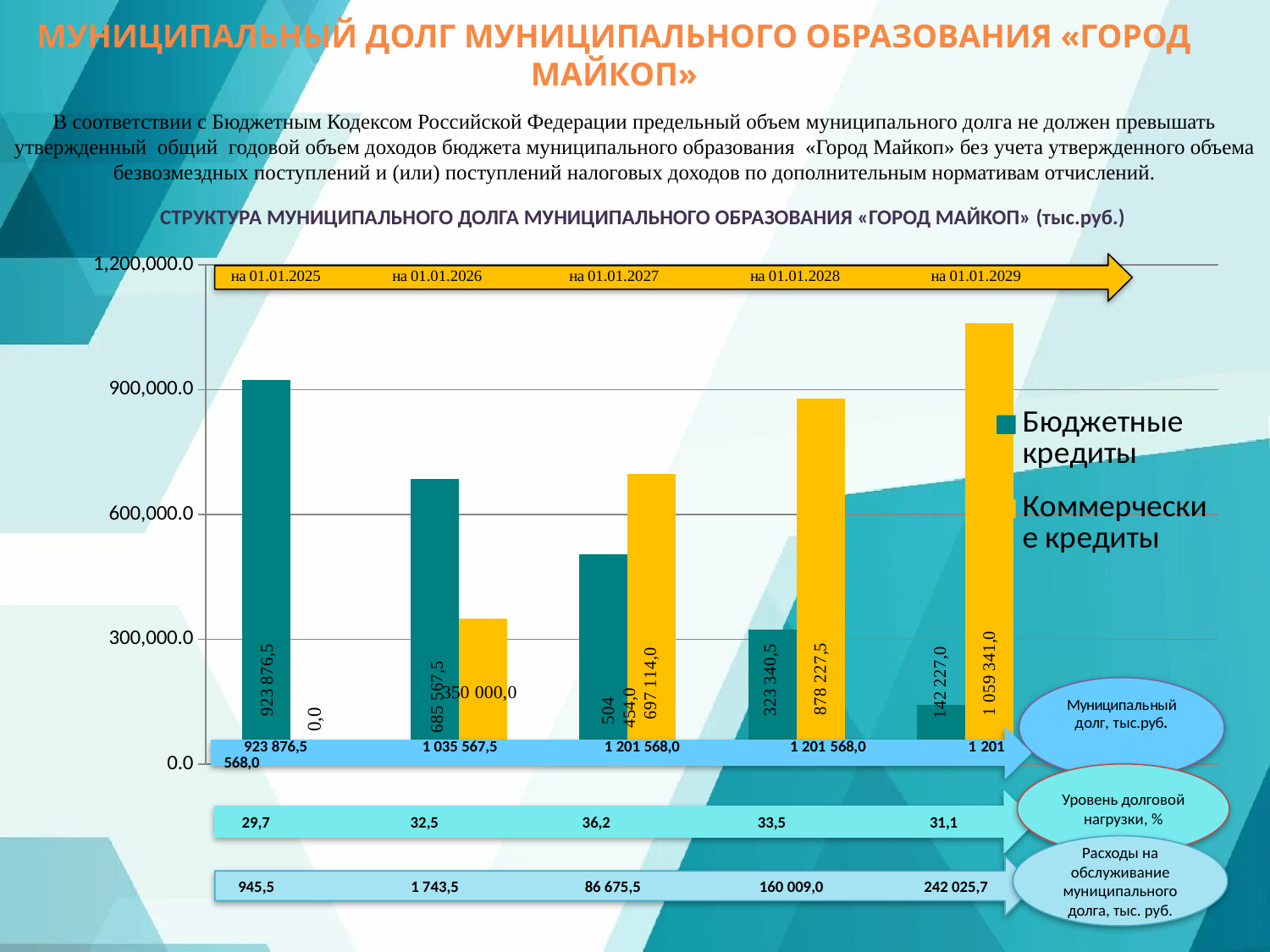
What is the value of Бюджетные кредиты на 01.01.2025? 923 876,5 What is the difference between Коммерческие кредиты and Бюджетные кредиты на 01.01.2027? 192 660,0 Do the values of Бюджетные кредиты rise or fall from 01.01.2025 to 01.01.2029? fall How many dates (categories) are shown along the x axis of the chart? 5 What type of chart is shown on the slide? bar chart Which colour represents Коммерческие кредиты in the chart? yellow What is the value of Коммерческие кредиты на 01.01.2026? 350 000,0 На 01.01.2028, which is larger: Бюджетные кредиты or Коммерческие кредиты? Коммерческие кредиты How many series does the chart legend list? 2 On which date is the value of Коммерческие кредиты the highest? на 01.01.2029 What is the value of Коммерческие кредиты на 01.01.2029? 1 059 341,0 On which date is the value of Бюджетные кредиты the lowest? на 01.01.2029